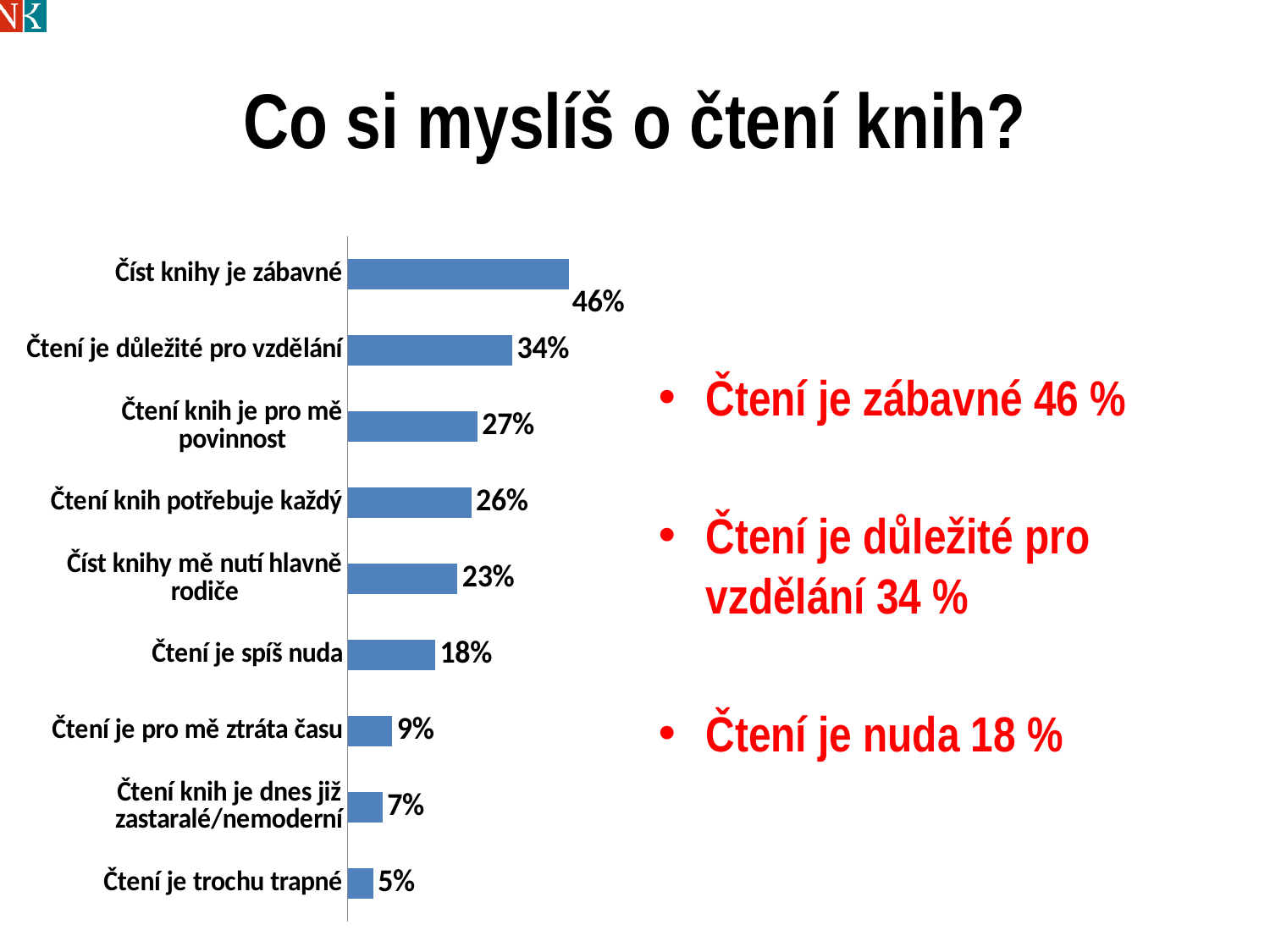
What colour are the bars in the chart? Blue What is the value for "Čtení je spíš nuda"? 18% What is the difference between "Čtení je spíš nuda" and "Čtení je pro mě ztráta času"? 9% Which category has the lowest value? Čtení je trochu trapné Which is larger: "Čtení knih je pro mě povinnost" or "Číst knihy mě nutí hlavně rodiče"? Čtení knih je pro mě povinnost Which category has the highest value? Číst knihy je zábavné What kind of chart is shown on the slide? Bar chart What is the value for "Čtení knih je dnes již zastaralé/nemoderní"? 7% What is the value for "Čtení knih potřebuje každý"? 26% How many categories does the chart show? 9 What is the value for "Číst knihy je zábavné"? 46% What is the difference between "Číst knihy je zábavné" and "Čtení je důležité pro vzdělání"? 12%